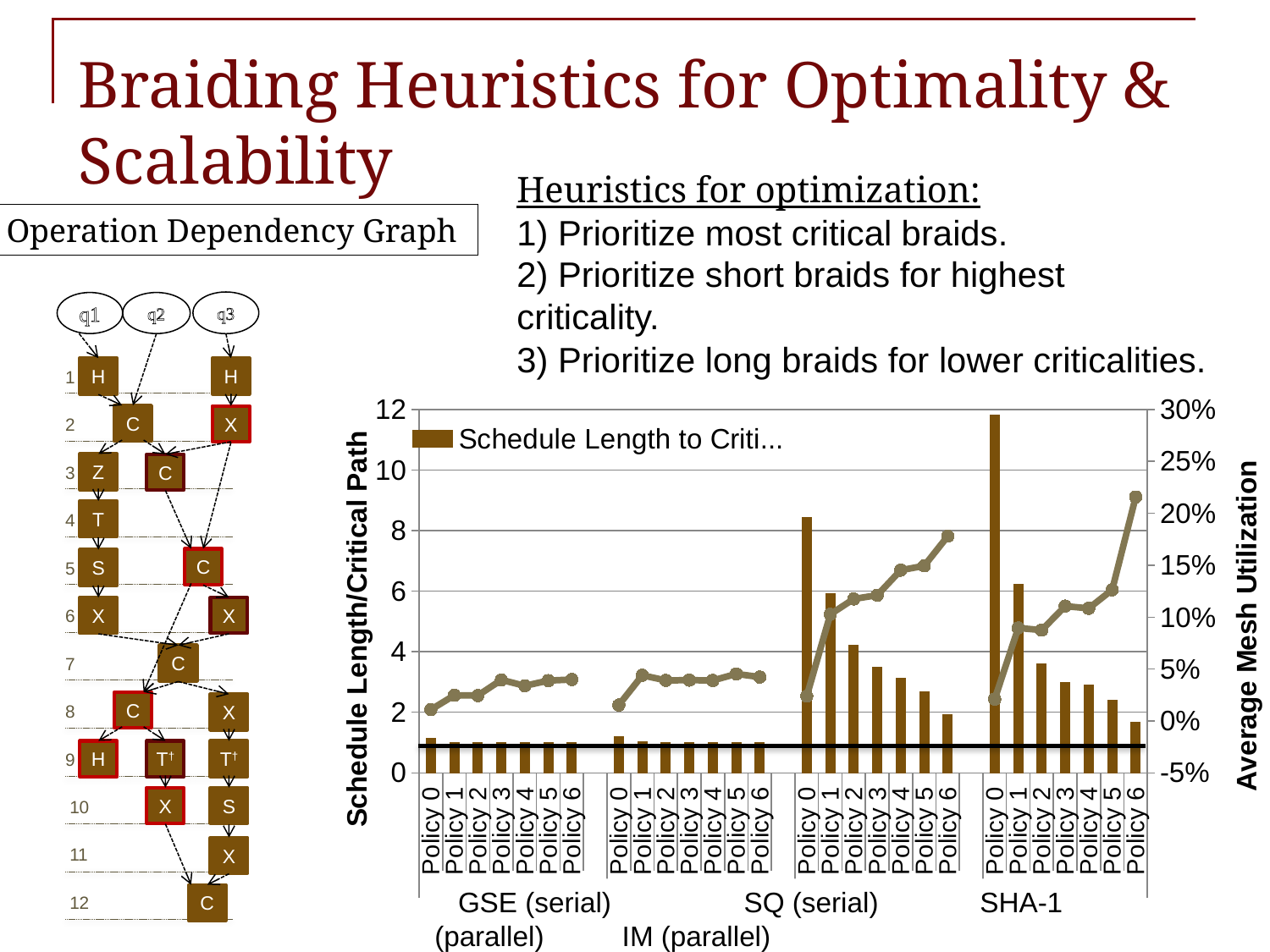
Which bar is taller: SQ (serial) Policy 0 or SHA-1 Policy 0? SHA-1 Policy 0 What is the title of the right-hand vertical axis? Average Mesh Utilization Which bar is the highest in the chart? SHA-1 Policy 0 How many benchmark groups are shown along the x axis? 4 What type of chart is shown on the slide? Combination bar and line chart Which bar is taller: SQ (serial) Policy 1 or SQ (serial) Policy 2? SQ (serial) Policy 1 How many policies are plotted for each benchmark group? 7 Is the Average Mesh Utilization for SHA-1 Policy 6 greater or less than 15%? greater Is the Schedule Length to Critical Path bar for GSE (serial) Policy 3 greater or less than 2? less Does the Average Mesh Utilization line rise or fall from Policy 0 to Policy 6 within the SHA-1 group? rise Is the Schedule Length to Critical Path bar for SHA-1 Policy 0 greater or less than 10? greater